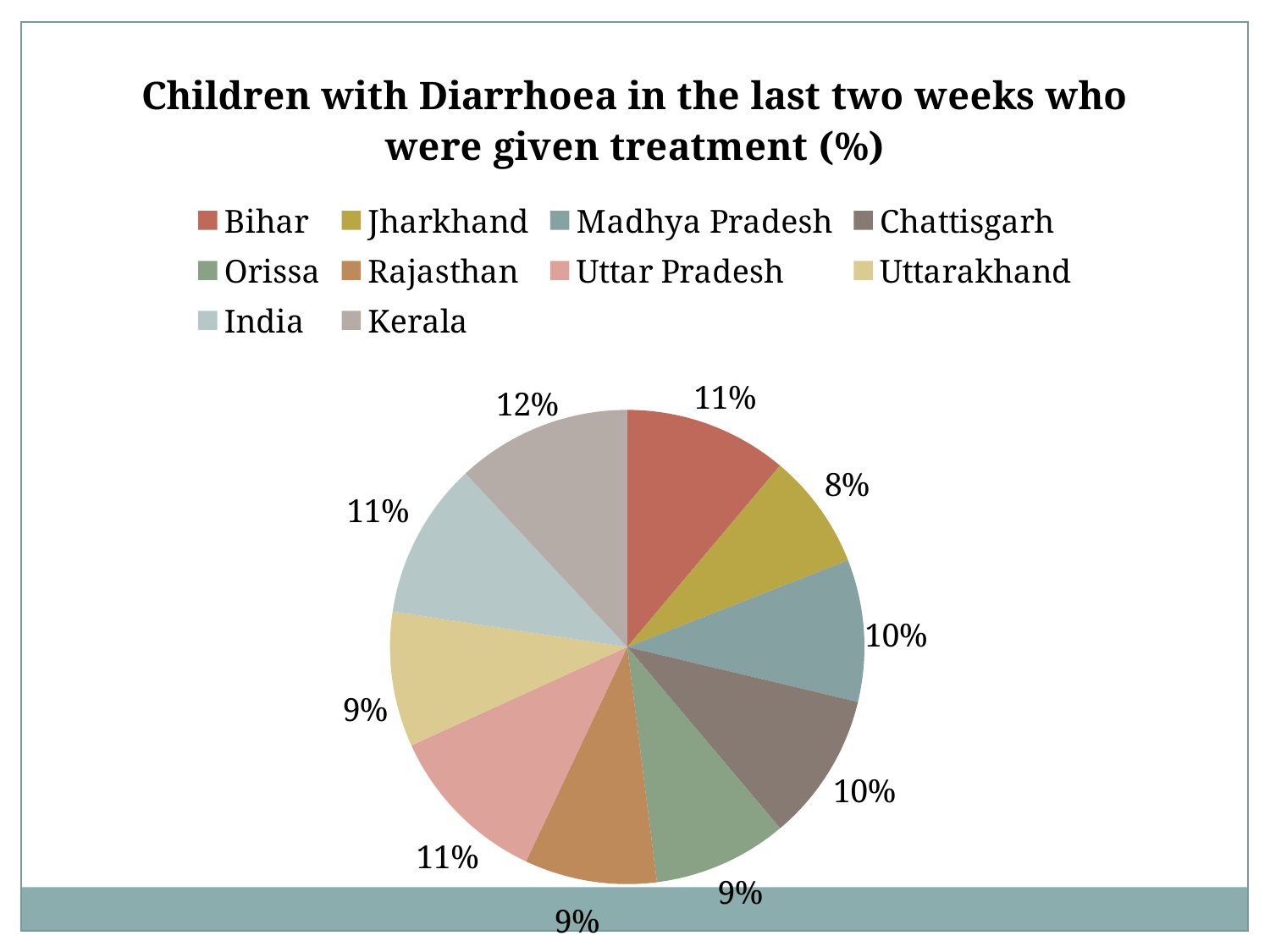
What share of the pie does Kerala represent? 12% What share of the pie does Bihar represent? 11% Which category has the largest slice of the pie? Kerala What share of the pie does Uttarakhand represent? 9% What kind of chart is shown on the slide? Pie chart Which category has the smallest slice of the pie? Jharkhand How many categories are shown in the pie chart? 10 What is the difference in percentage points between the Kerala slice and the Jharkhand slice? 4 What is the title of the chart? Children with Diarrhoea in the last two weeks who were given treatment (%) Which slice is larger, Bihar or Jharkhand? Bihar